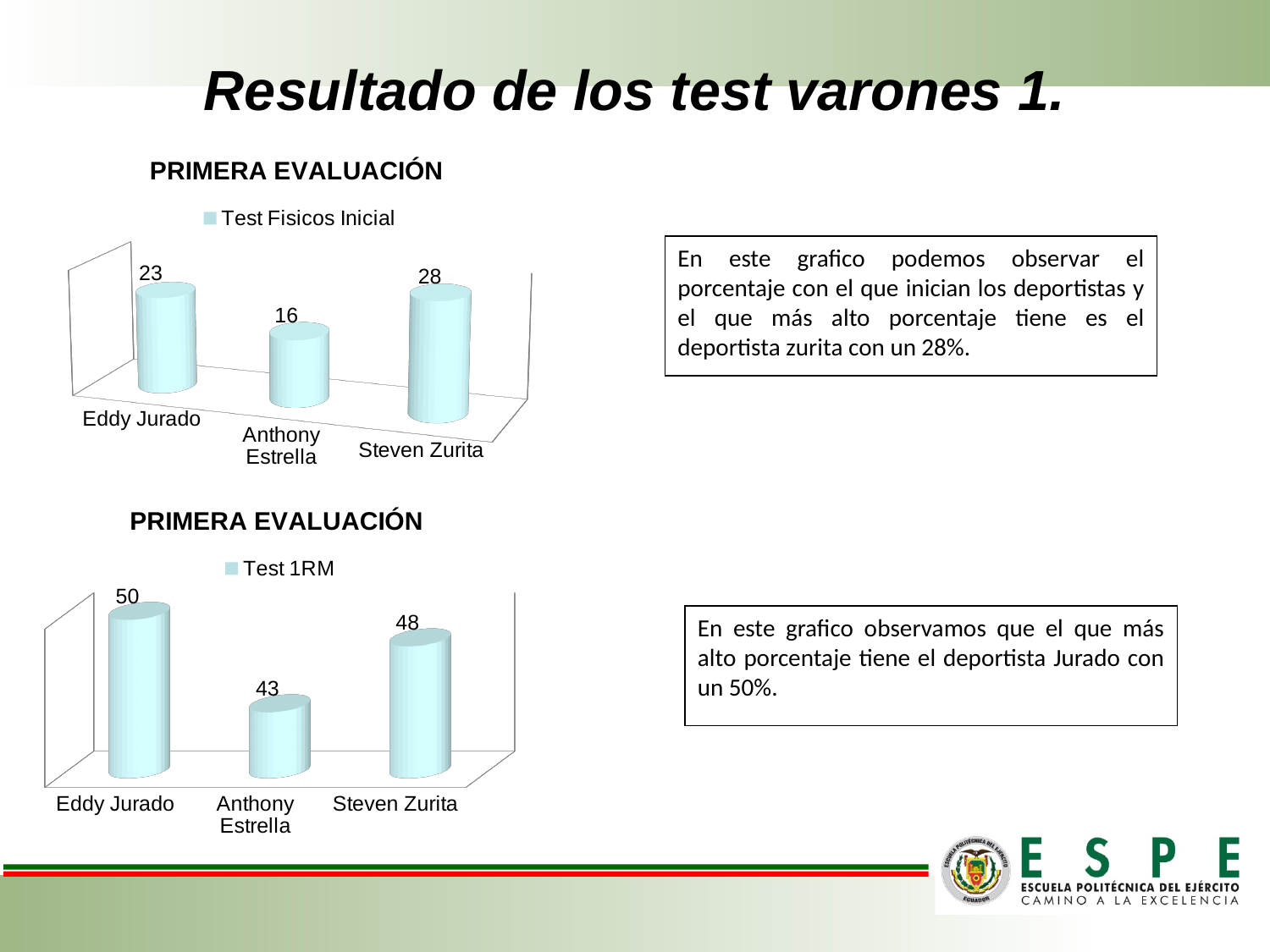
How many athletes are shown in the top chart (Test Fisicos Inicial)? 3 What type of chart is the bottom chart (Test 1RM)? Bar chart In the bottom chart (Test 1RM), what is the difference between Eddy Jurado's and Anthony Estrella's values? 7 In the top chart (Test Fisicos Inicial), which athlete has the lowest value? Anthony Estrella In the top chart (Test Fisicos Inicial), what is the value for Steven Zurita? 28 In the top chart (Test Fisicos Inicial), what is the difference between Steven Zurita's and Eddy Jurado's values? 5 In the top chart (Test Fisicos Inicial), which athlete has the highest value? Steven Zurita In the top chart (Test Fisicos Inicial), what is the value for Anthony Estrella? 16 In the bottom chart (Test 1RM), which athlete has the highest value? Eddy Jurado In the bottom chart (Test 1RM), what is the value for Anthony Estrella? 43 In the bottom chart (Test 1RM), which is larger, the value for Steven Zurita or the value for Anthony Estrella? Steven Zurita In the bottom chart (Test 1RM), what is the value for Eddy Jurado? 50